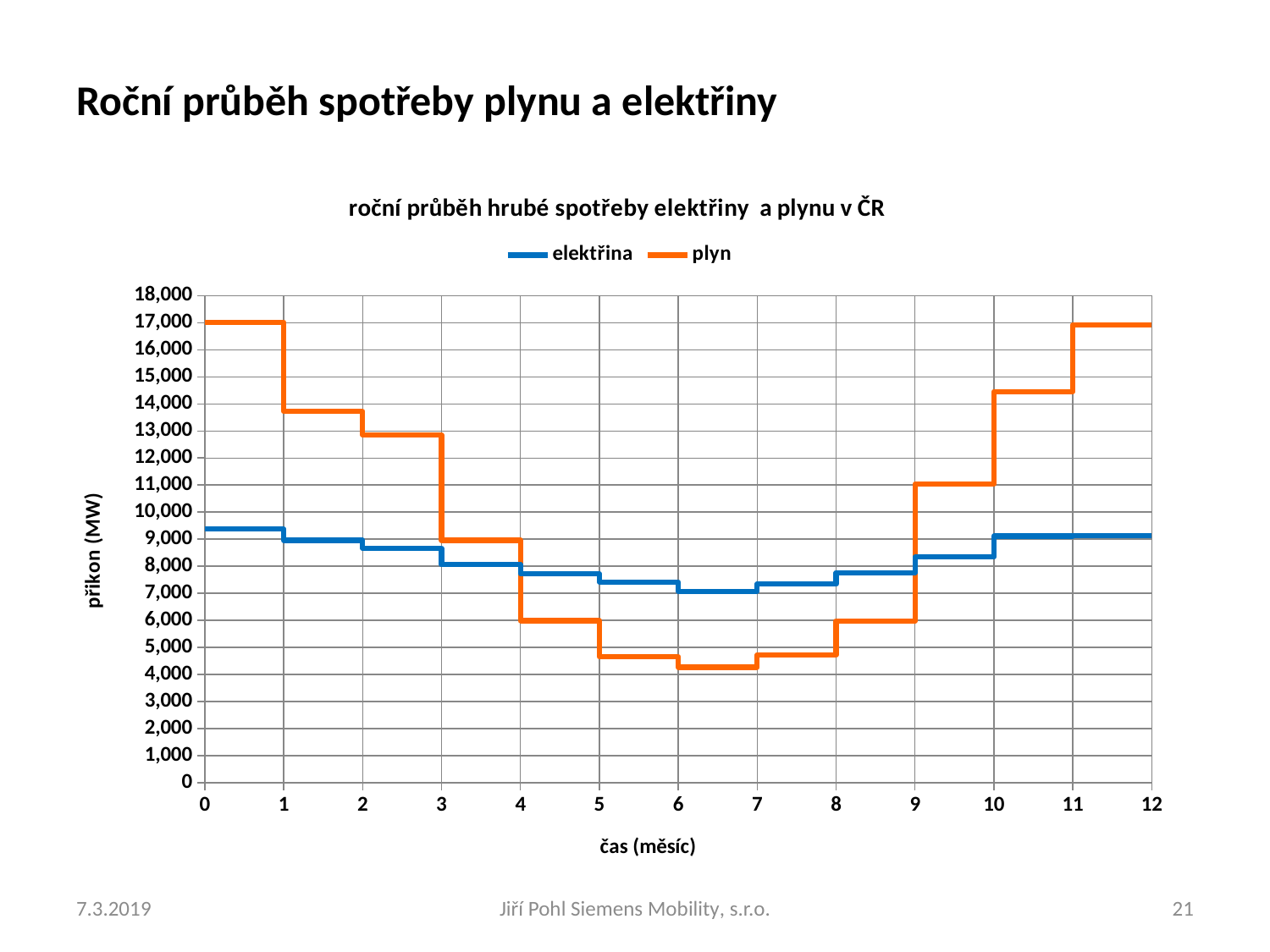
Is the value for plyn between months 6 and 7 greater or less than 5,000? less Is the value for elektřina between months 0 and 1 greater or less than 9,000? greater Between months 6 and 7, which series has the higher value, elektřina or plyn? elektřina Which series is drawn in orange? plyn What kind of chart is shown on the slide? line chart Does the plyn series rise or fall from month 0 to month 6? fall How many series does the legend list? 2 Is the value for plyn between months 0 and 1 greater or less than 16,000? greater What is the title of the vertical axis? příkon (MW) Between months 0 and 1, which series has the higher value, elektřina or plyn? plyn